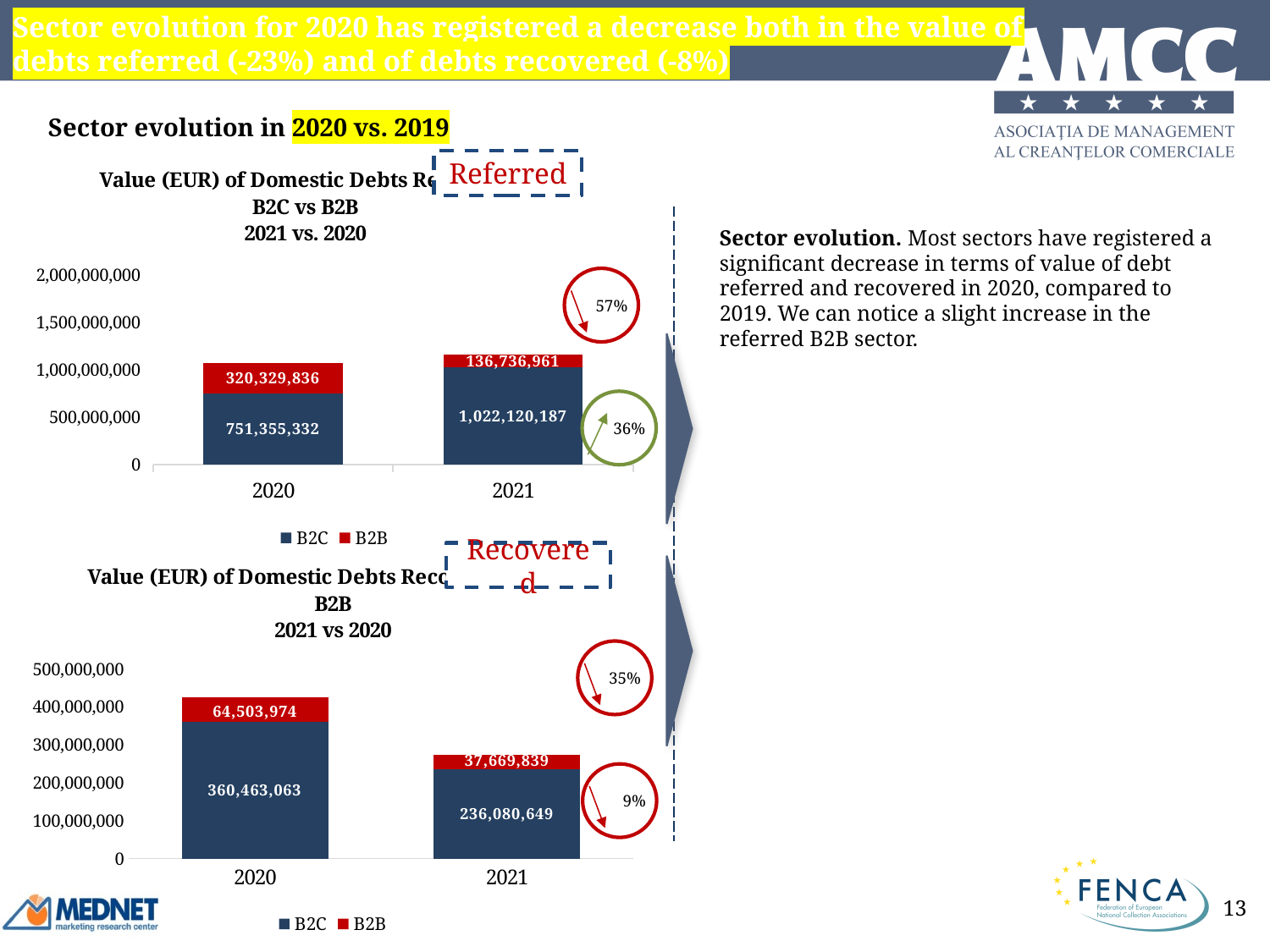
In the top chart (Domestic Debts Referred), what is the total of the stacked bar for 2020? 1,071,685,168 What type of chart is the top chart (Domestic Debts Referred)? stacked bar chart In the top chart (Domestic Debts Referred), by how much did the B2C value increase from 2020 to 2021? 270,764,855 In the bottom chart (Domestic Debts Recovered), does the B2C value rise or fall from 2020 to 2021? fall In the top chart (Domestic Debts Referred), which year has the larger B2B value, 2020 or 2021? 2020 In the bottom chart (Domestic Debts Recovered), what is the total of the stacked bar for 2021? 273,750,488 In the bottom chart (Domestic Debts Recovered), what is the B2C value for 2020? 360,463,063 In the top chart (Domestic Debts Referred), what is the B2C value for 2021? 1,022,120,187 How many series does the legend of the bottom chart (Domestic Debts Recovered) list? 2 In the bottom chart (Domestic Debts Recovered), what is the difference between the B2B values for 2020 and 2021? 26,834,135 In the bottom chart (Domestic Debts Recovered), what is the B2B value for 2021? 37,669,839 In the top chart (Domestic Debts Referred), what is the B2B value for 2020? 320,329,836